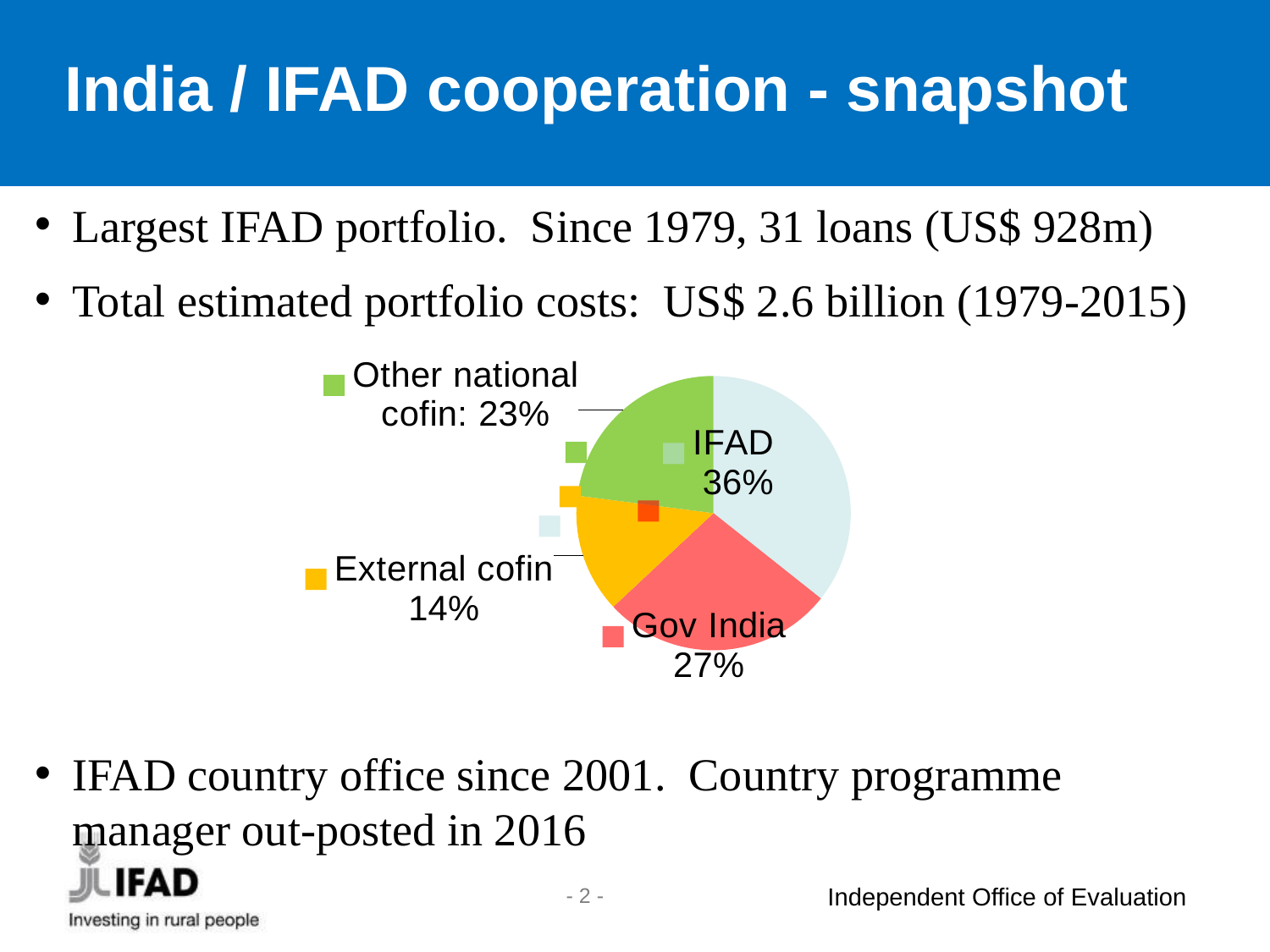
What is the difference in percentage points between the Other national cofin slice and the External cofin slice? 9 Which slice of the pie chart is the largest? IFAD Which slice of the pie chart is the smallest? External cofin What share of the pie does External cofin account for? 14% What share of the pie does IFAD account for? 36% Which is larger, the Gov India slice or the Other national cofin slice? Gov India What share of the pie does Gov India account for? 27% How many slices does the pie chart have? 4 What is the difference in percentage points between the IFAD slice and the Gov India slice? 9 What colour is the Gov India slice of the pie chart? Red What share of the pie does Other national cofin account for? 23% What kind of chart is shown on the slide? Pie chart